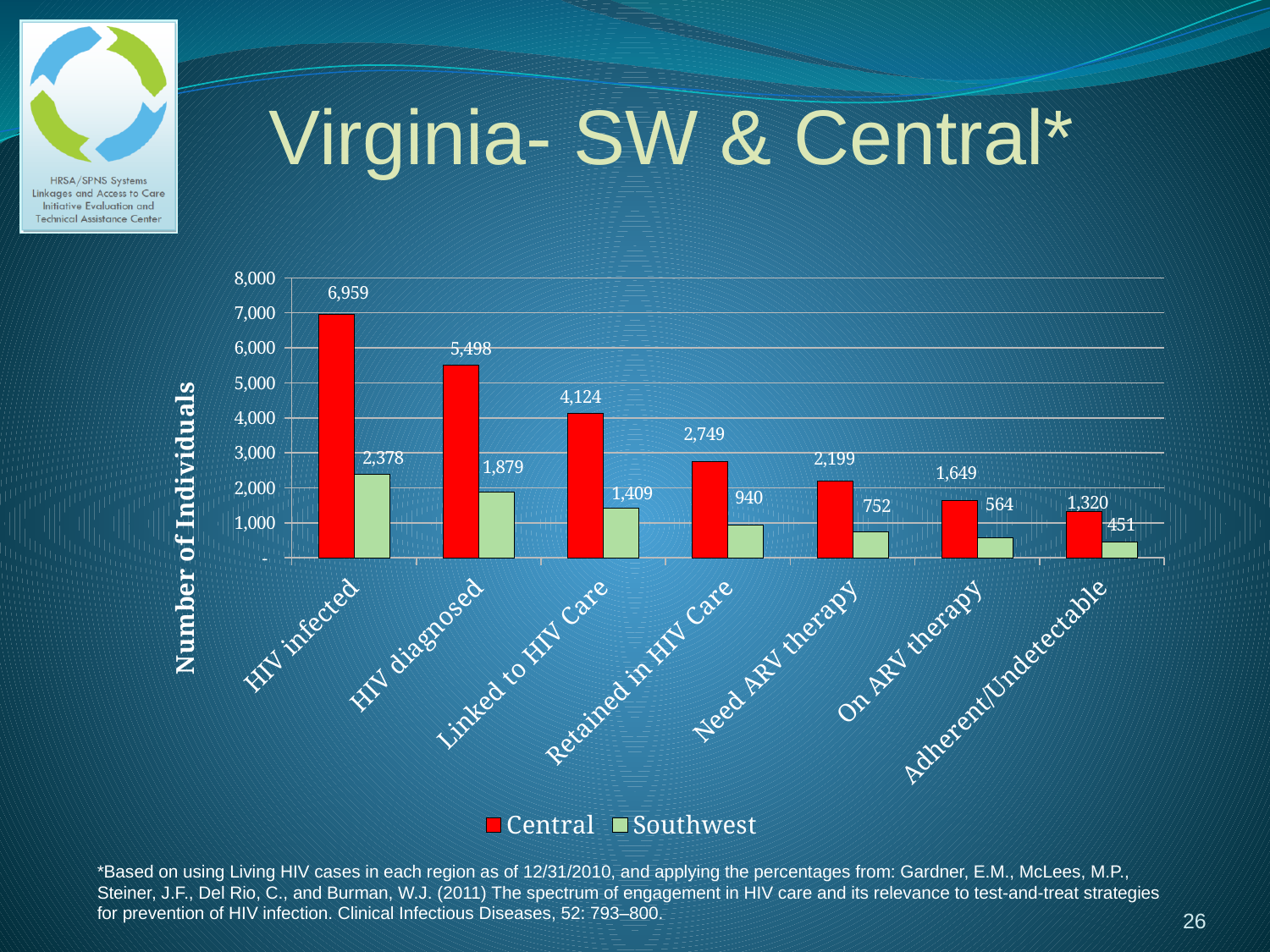
Do the Central values rise or fall from left to right along the x axis? Fall What is the Southwest value for Adherent/Undetectable? 451 Which category has the highest Central value? HIV infected What kind of chart is shown on the slide? Bar chart Which category has the lowest Southwest value? Adherent/Undetectable What is the difference between the Central and Southwest values for HIV diagnosed? 3,619 What is the Southwest value for Linked to HIV Care? 1,409 Which is larger: the Central value for Retained in HIV Care or the Central value for Need ARV therapy? Retained in HIV Care What is the Central value for On ARV therapy? 1,649 How many categories are shown on the x axis? 7 What is the Central value for HIV infected? 6,959 How many series does the legend list? 2